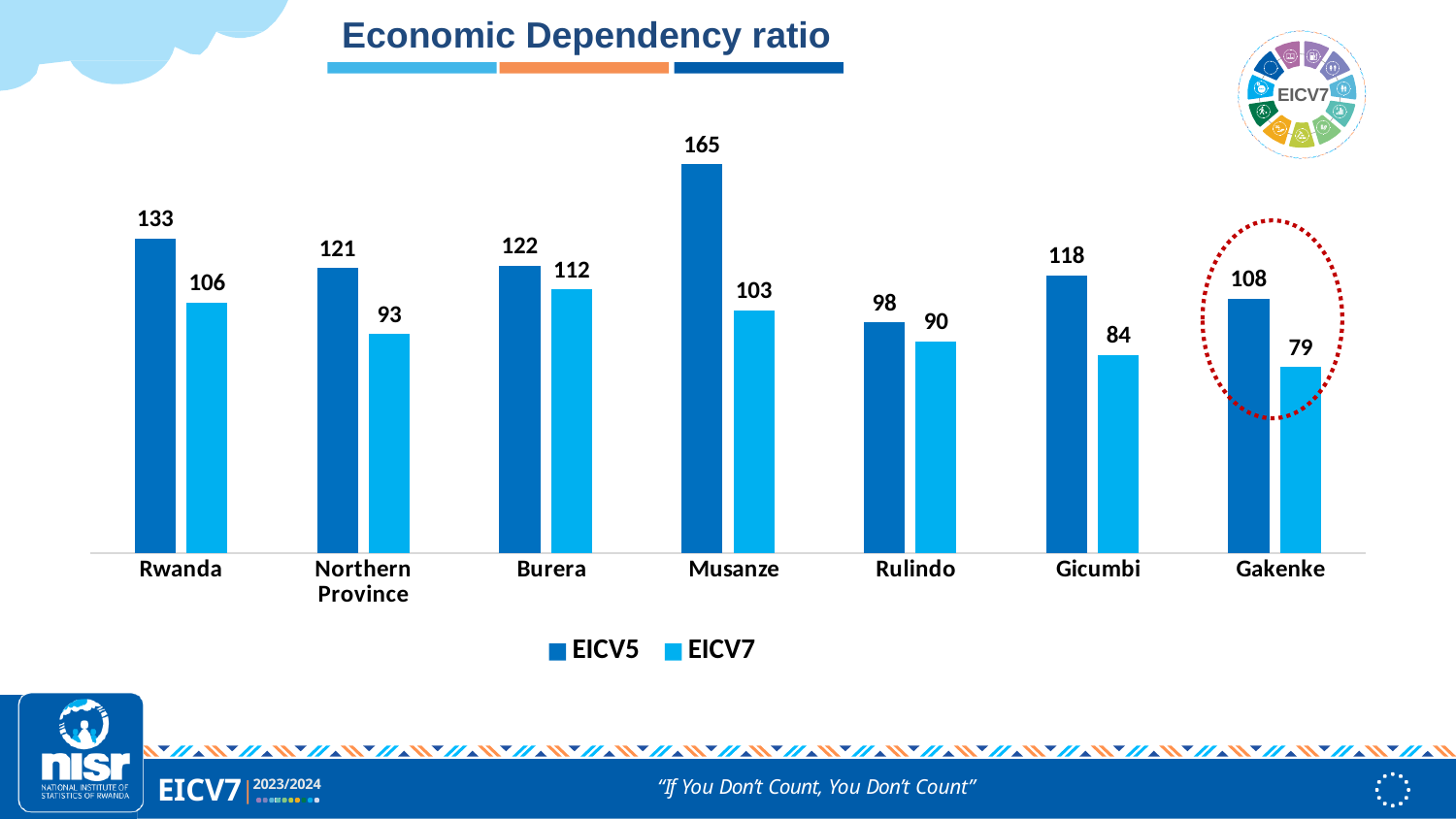
Which is larger, the EICV7 value for Burera or the EICV7 value for Rulindo? Burera What kind of chart is shown on the slide? Bar chart How many categories are shown on the x axis? 7 How many series does the legend list? 2 What is the EICV7 value for Rwanda? 106 What is the difference between the EICV5 and EICV7 values for Musanze? 62 What is the EICV5 value for Gicumbi? 118 What is the EICV5 value for Musanze? 165 What is the EICV7 value for Gakenke? 79 Which category has the lowest EICV7 value? Gakenke What is the title of the chart? Economic Dependency ratio Which category has the highest EICV5 value? Musanze